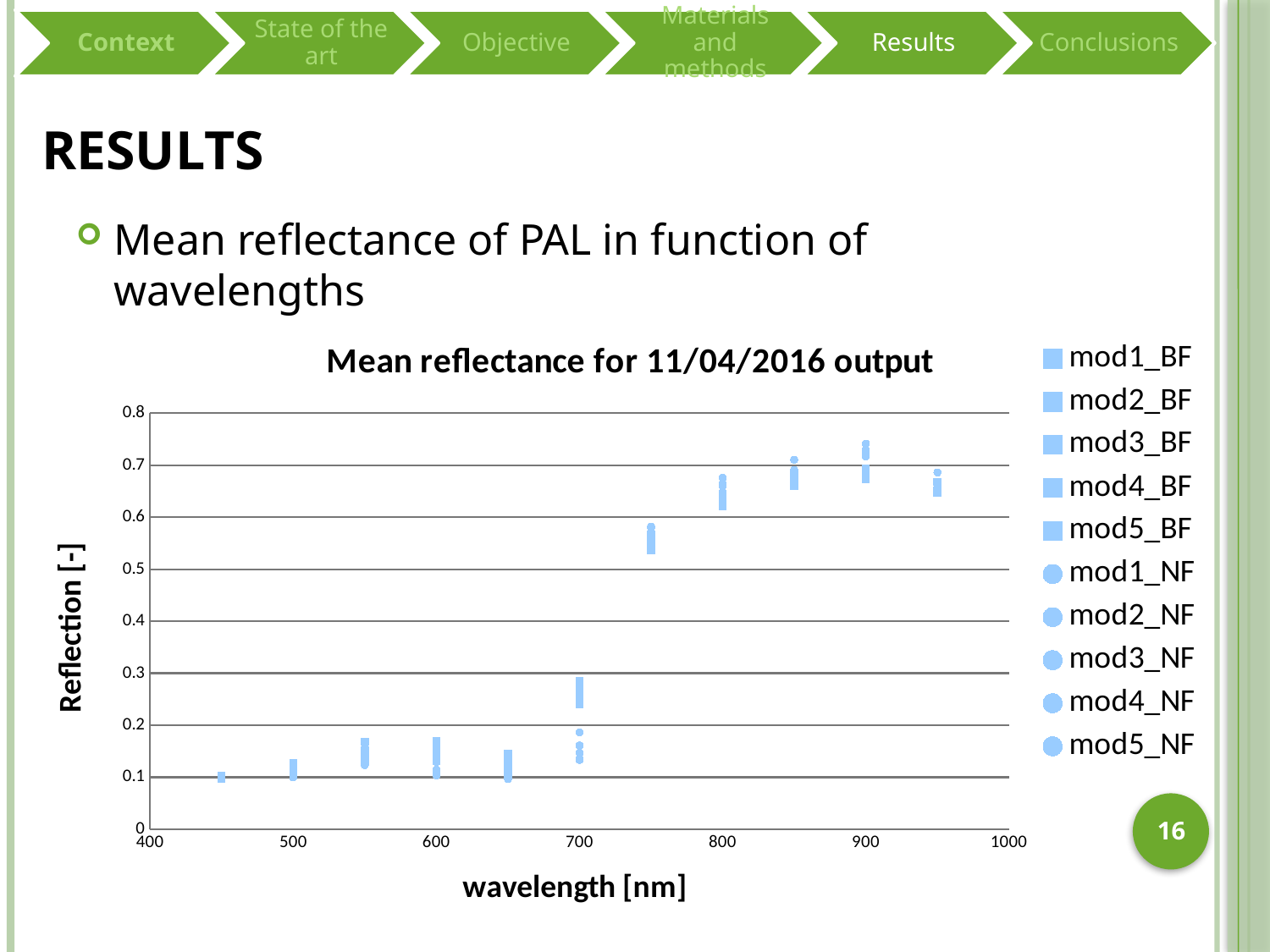
Are the reflection values at 900 nm greater or less than 0.6? greater Are the reflection values at 750 nm greater or less than 0.5? greater Are the reflection values at 750 nm greater or less than 0.6? less What is the label of the x axis? wavelength [nm] What is the title of the chart? Mean reflectance for 11/04/2016 output What kind of chart is shown on the slide? scatter chart Which is larger, the reflection at 800 nm or the reflection at 600 nm? 800 nm How many series does the chart legend list? 10 At how many distinct wavelengths are points plotted? 11 Do the reflection values generally rise or fall as wavelength increases from 450 nm to 950 nm? rise